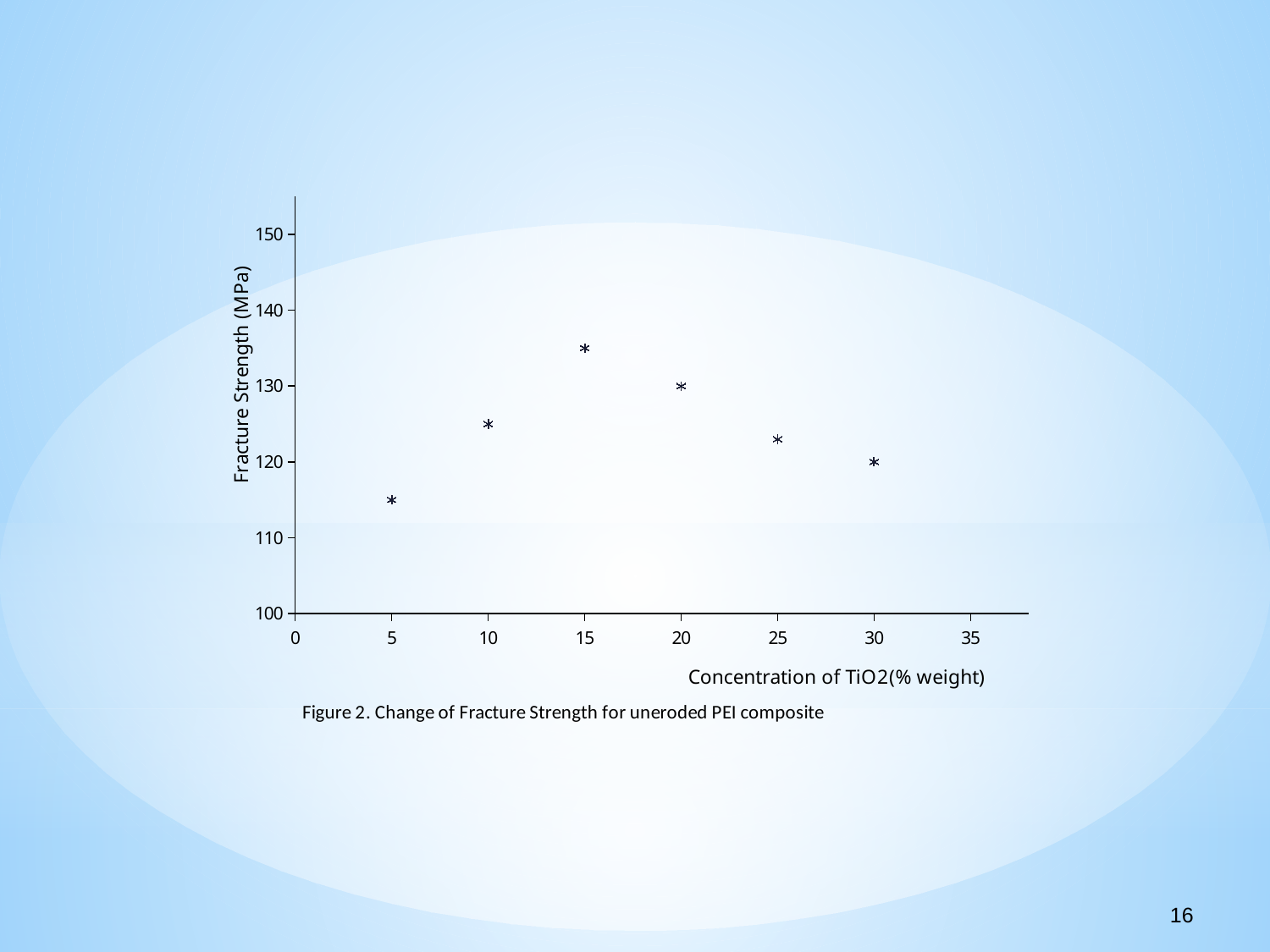
Is the fracture strength at a TiO2 concentration of 5 greater or less than 120? less Does the fracture strength rise or fall as the TiO2 concentration increases from 15 to 30? fall What is the caption of the figure below the chart? Figure 2. Change of Fracture Strength for uneroded PEI composite At which TiO2 concentration is the fracture strength highest? 15 How many data points are plotted on the chart? 6 What is the label of the y axis? Fracture Strength (MPa) Is the fracture strength at a TiO2 concentration of 15 greater or less than 130? greater Which has a higher fracture strength: a TiO2 concentration of 15 or 25? 15 Is the fracture strength at a TiO2 concentration of 10 greater or less than 120? greater What kind of chart is shown on the slide? scatter chart At which TiO2 concentration is the fracture strength lowest? 5